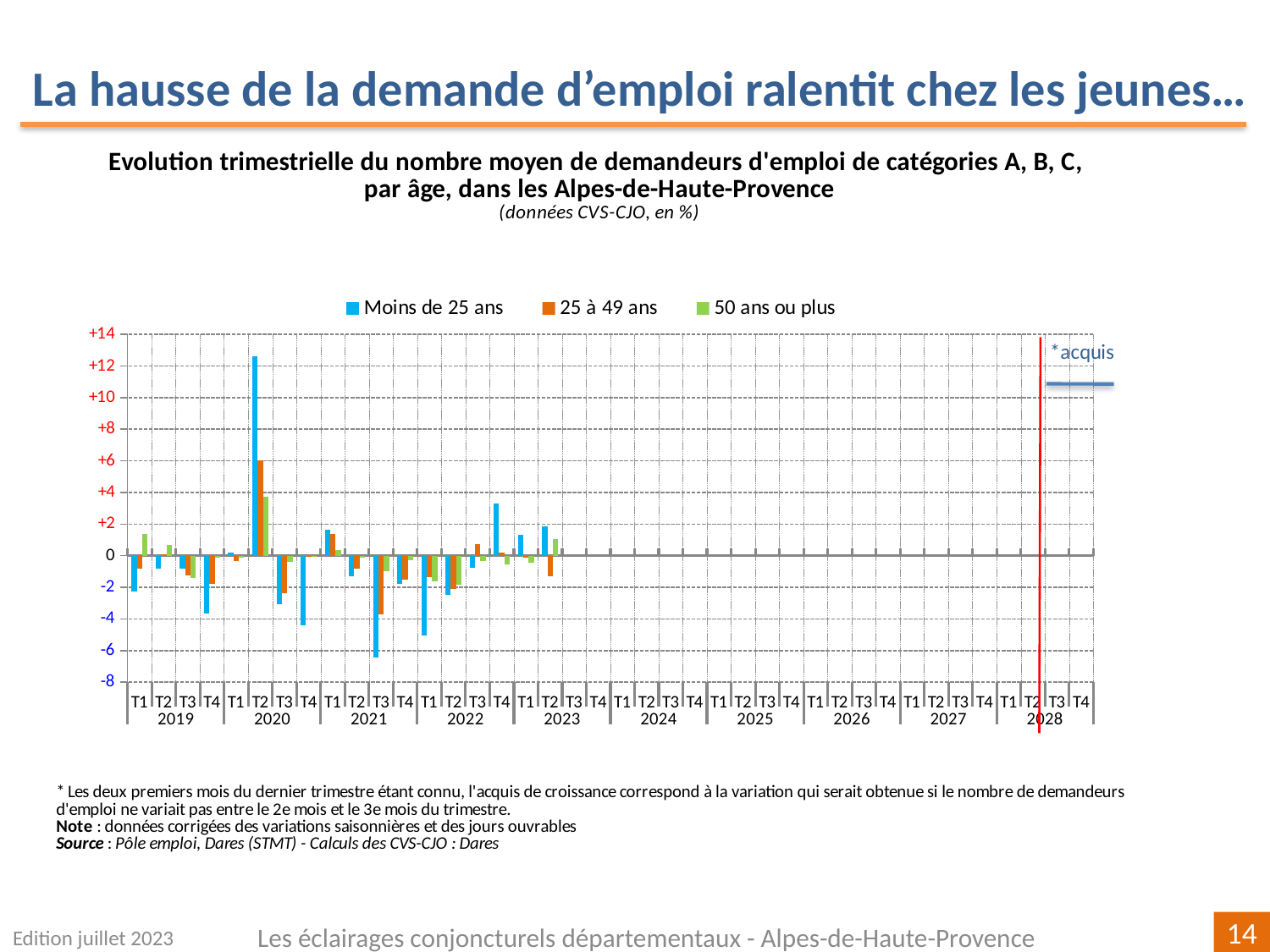
Is the value for 'Moins de 25 ans' in T2 2020 greater or less than +10? greater Is the value for 'Moins de 25 ans' in T3 2021 greater or less than -4? less Is the value for '25 à 49 ans' in T2 2020 greater or less than +4? greater Which series is shown in blue in the legend? Moins de 25 ans How many series does the legend list? 3 In which quarter does the 'Moins de 25 ans' series reach its lowest value? T3 2021 How many years are labelled along the x axis? 10 What kind of chart is shown on the slide? bar chart In T2 2020, which series has the larger value: 'Moins de 25 ans' or '25 à 49 ans'? Moins de 25 ans Which series has the lowest value in T3 2021? Moins de 25 ans In which quarter does the 'Moins de 25 ans' series reach its highest value? T2 2020